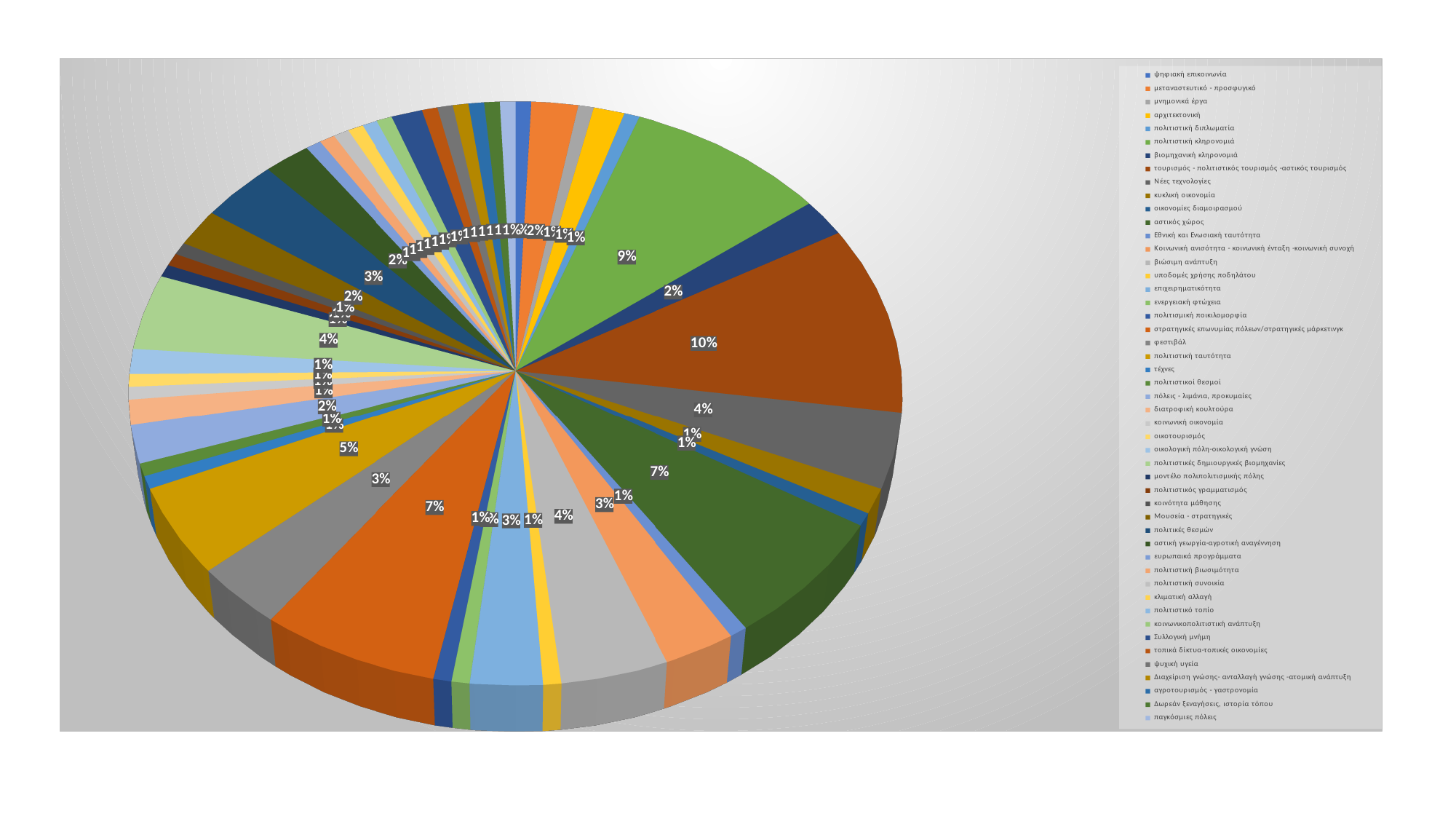
What is the largest percentage shown on any slice of the pie chart? 10% What share of the pie does the slice for 'αστικός χώρος' have? 7% What share of the pie does the slice for 'πολιτιστική κληρονομιά' have? 9% What share of the pie does the slice for 'Νέες τεχνολογίες' have? 4% What is the smallest percentage shown on any slice of the pie chart? 1% By how many percentage points does the 'τουρισμός - πολιτιστικός τουρισμός - αστικός τουρισμός' slice exceed the 'αστικός χώρος' slice? 3 percentage points What is the first entry listed in the legend? ψηφιακή επικοινωνία What kind of chart is shown on the slide? pie chart Which slice is larger: 'τουρισμός - πολιτιστικός τουρισμός - αστικός τουρισμός' or 'πολιτιστική κληρονομιά'? τουρισμός - πολιτιστικός τουρισμός - αστικός τουρισμός What is the last entry listed in the legend? παγκόσμιες πόλεις